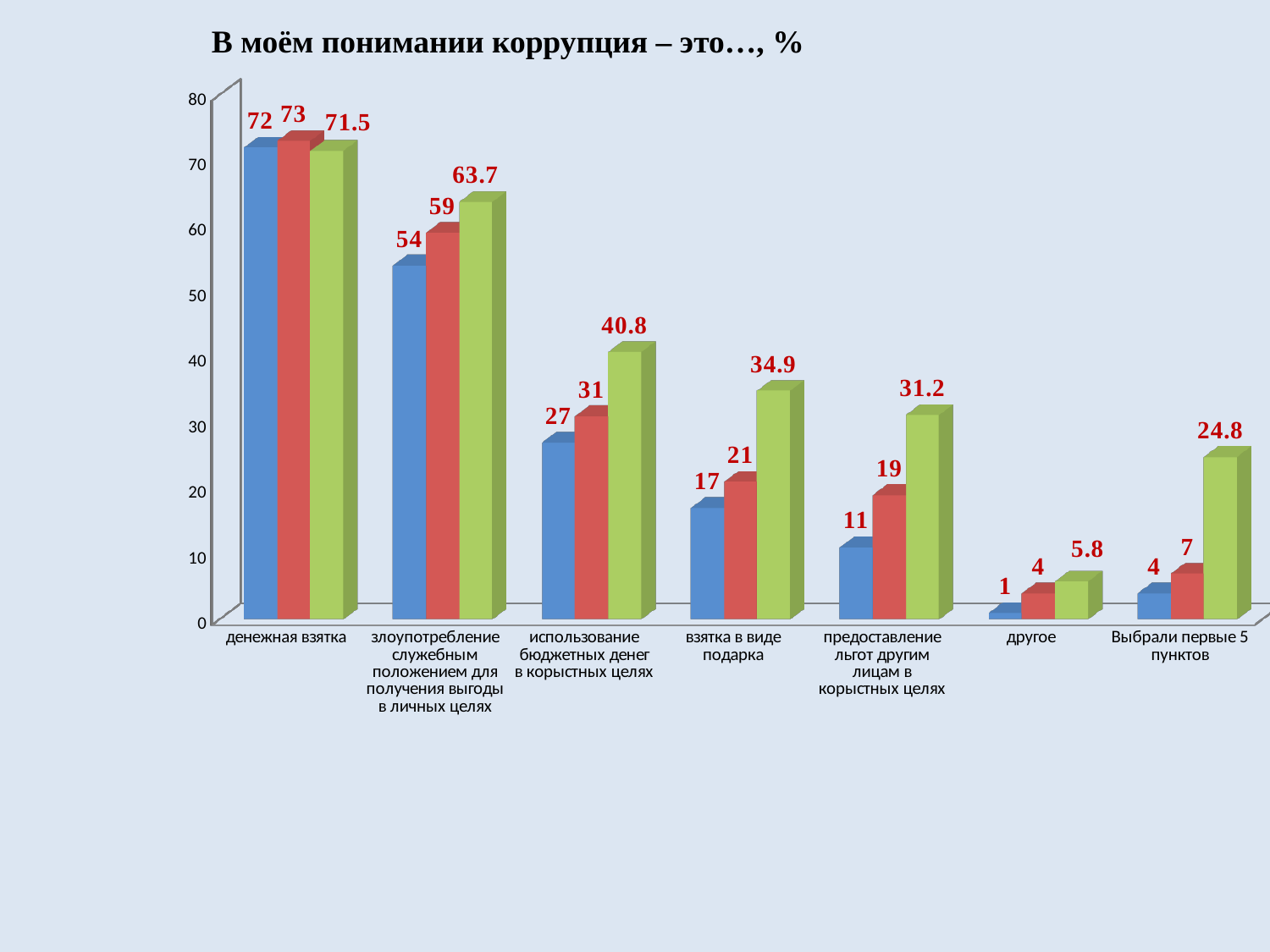
What is the value of the red bar for "взятка в виде подарка"? 21 What is the difference between the green and blue bars for "использование бюджетных денег в корыстных целях"? 13.8 What is the value of the green bar for "злоупотребление служебным положением для получения выгоды в личных целях"? 63.7 What is the value of the blue bar for "денежная взятка"? 72 Which category has the lowest blue bar? другое What type of chart is shown on the slide? bar chart What is the title of the chart? В моём понимании коррупция – это…, % What is the value of the green bar for "Выбрали первые 5 пунктов"? 24.8 How many bars are shown for each category? 3 How many categories are shown on the x axis? 7 Which category has the highest green bar? денежная взятка Which is larger for "предоставление льгот другим лицам в корыстных целях": the red bar or the green bar? the green bar